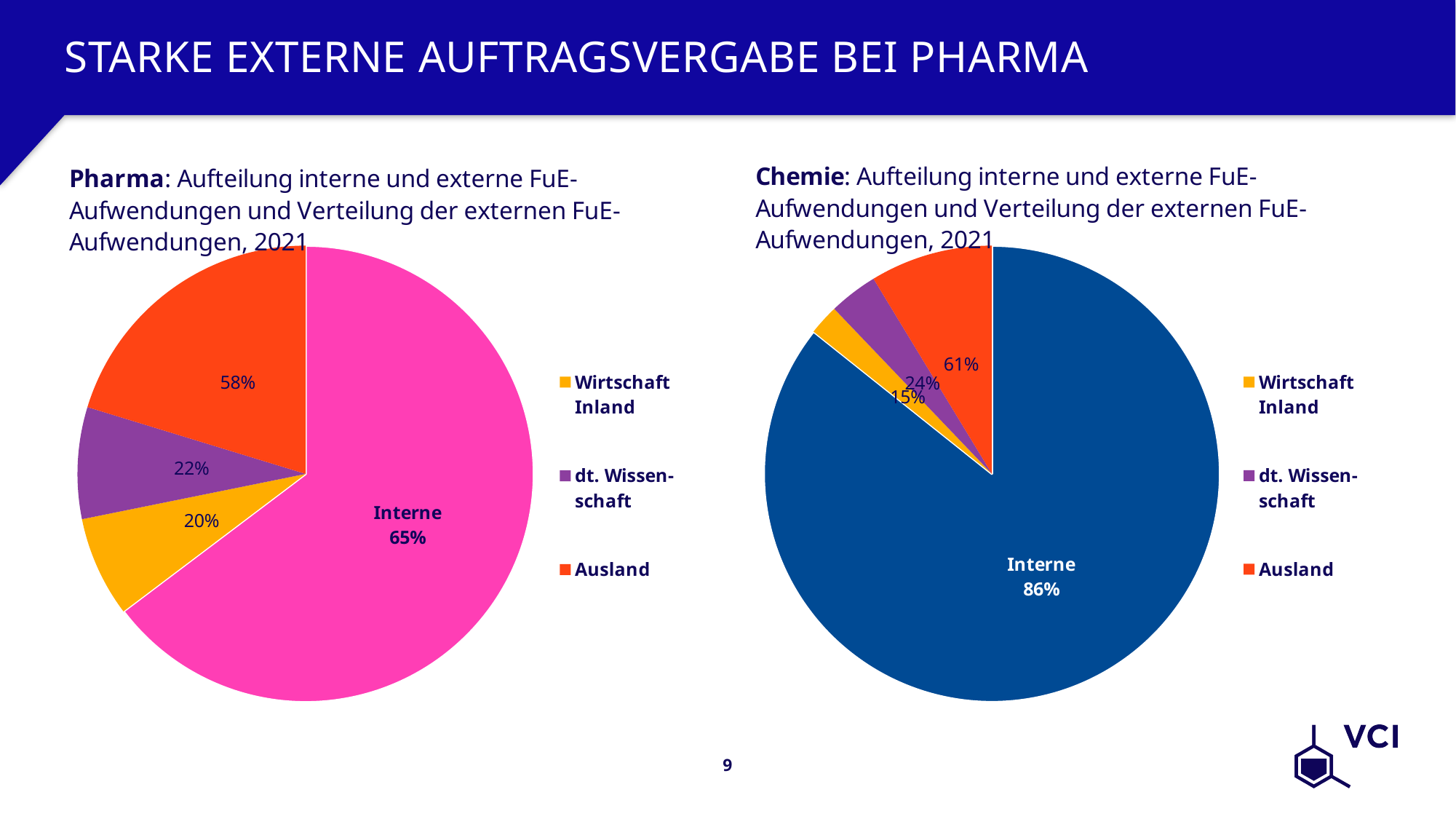
What type of chart is used on this slide? Pie chart In the Pharma chart, which of the external categories (Wirtschaft Inland, dt. Wissenschaft, Ausland) has the largest share? Ausland In the Chemie chart, what percentage is labelled for Interne? 86% In the Pharma chart, what percentage is shown on the Wirtschaft Inland slice? 20% Is the Ausland share larger in the Pharma chart or in the Chemie chart? Chemie In the Chemie chart, what percentage is shown on the Wirtschaft Inland slice? 15% What is the difference between the Interne percentage in the Chemie chart and the Interne percentage in the Pharma chart? 21 percentage points In the Chemie chart, which of the external categories (Wirtschaft Inland, dt. Wissenschaft, Ausland) has the smallest share? Wirtschaft Inland In the Pharma chart, what percentage is labelled for Interne? 65% In the Pharma chart, what percentage is shown on the Ausland slice? 58% In the Chemie chart, what percentage is shown on the dt. Wissenschaft slice? 24% How many entries does the legend of the Pharma chart list? 3